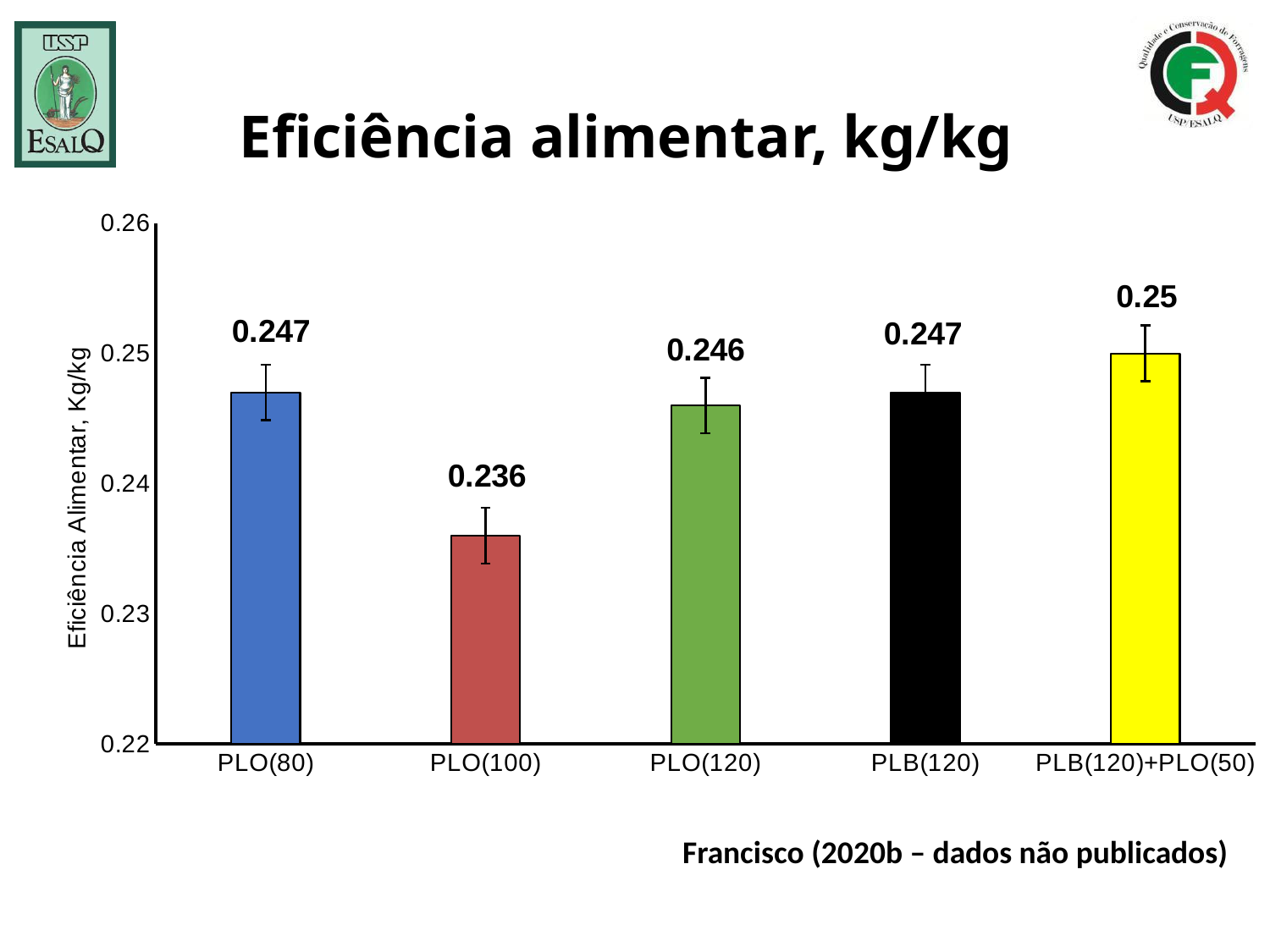
What is the value for PLB(120)+PLO(50)? 0.25 What is the y-axis label of the chart? Eficiência Alimentar, Kg/kg What is the value for PLO(100)? 0.236 What kind of chart is shown? bar chart What is the value for PLO(120)? 0.246 What is the value for PLO(80)? 0.247 What is the difference between the values for PLB(120)+PLO(50) and PLO(100)? 0.014 How many categories are shown on the x axis? 5 Is the value for PLO(100) greater or less than 0.24? less Which is larger, the value for PLO(80) or the value for PLO(100)? PLO(80) Which category has the highest value? PLB(120)+PLO(50) Which category has the lowest value? PLO(100)